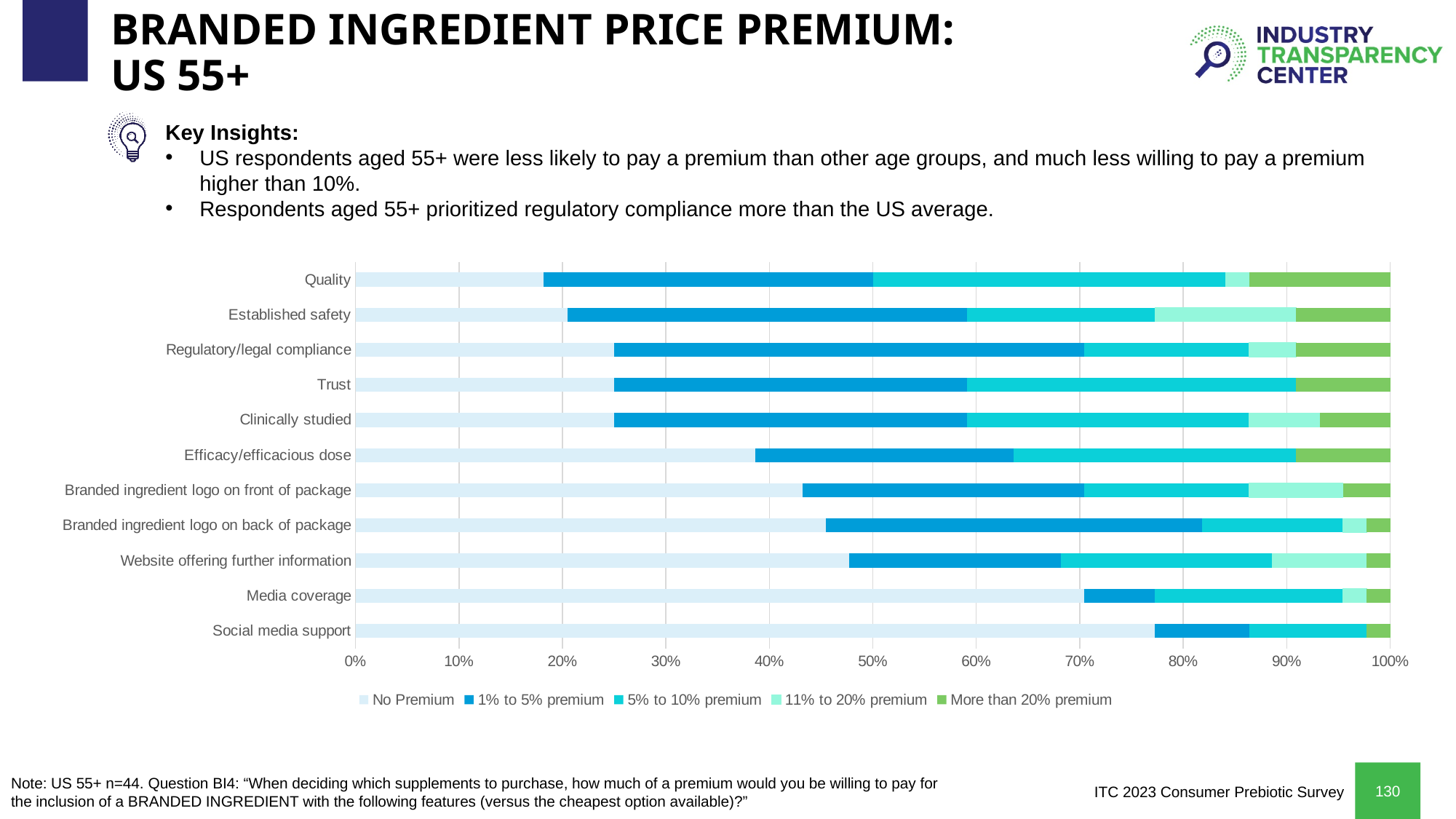
Is the 'No Premium' share for Quality greater or less than 20%? less Which category has the smallest 'No Premium' share? Quality How many series does the chart legend list? 5 Which legend entry represents the highest premium level? More than 20% premium What kind of chart is shown on the slide? Stacked bar chart Is the 'No Premium' share for Media coverage greater or less than 60%? greater Is the 'No Premium' share for Social media support greater or less than 70%? greater How many feature categories are listed on the chart's vertical axis? 11 Which has the larger 'No Premium' share: Media coverage or Website offering further information? Media coverage Which category has the largest 'No Premium' share? Social media support What does each stacked bar total on the horizontal axis? 100% Moving down the categories from Quality to Social media support, does the 'No Premium' share generally increase or decrease? increase